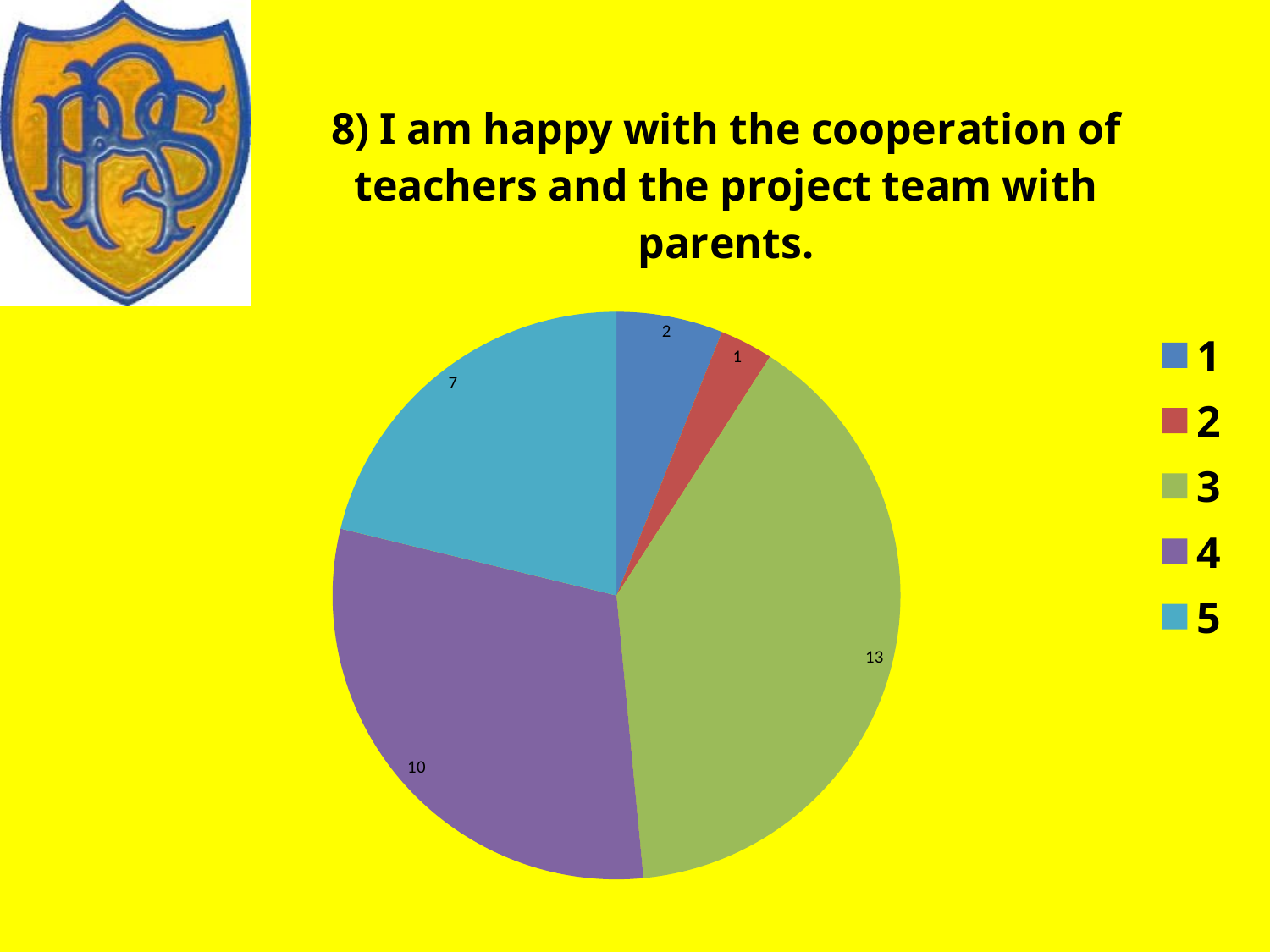
Which category has the smallest slice of the pie chart? 2 What is the value for category 1 in the pie chart? 2 What type of chart is shown on the slide? pie chart What colour is the slice for category 4 in the pie chart? purple What is the total of all the slices in the pie chart? 33 What is the value for category 5 in the pie chart? 7 What is the value for category 4 in the pie chart? 10 Which is larger, the value for category 5 or the value for category 1? 5 Which category has the largest slice of the pie chart? 3 What is the value for category 3 in the pie chart? 13 How many categories does the legend of the pie chart list? 5 What is the difference between the values for category 3 and category 4? 3